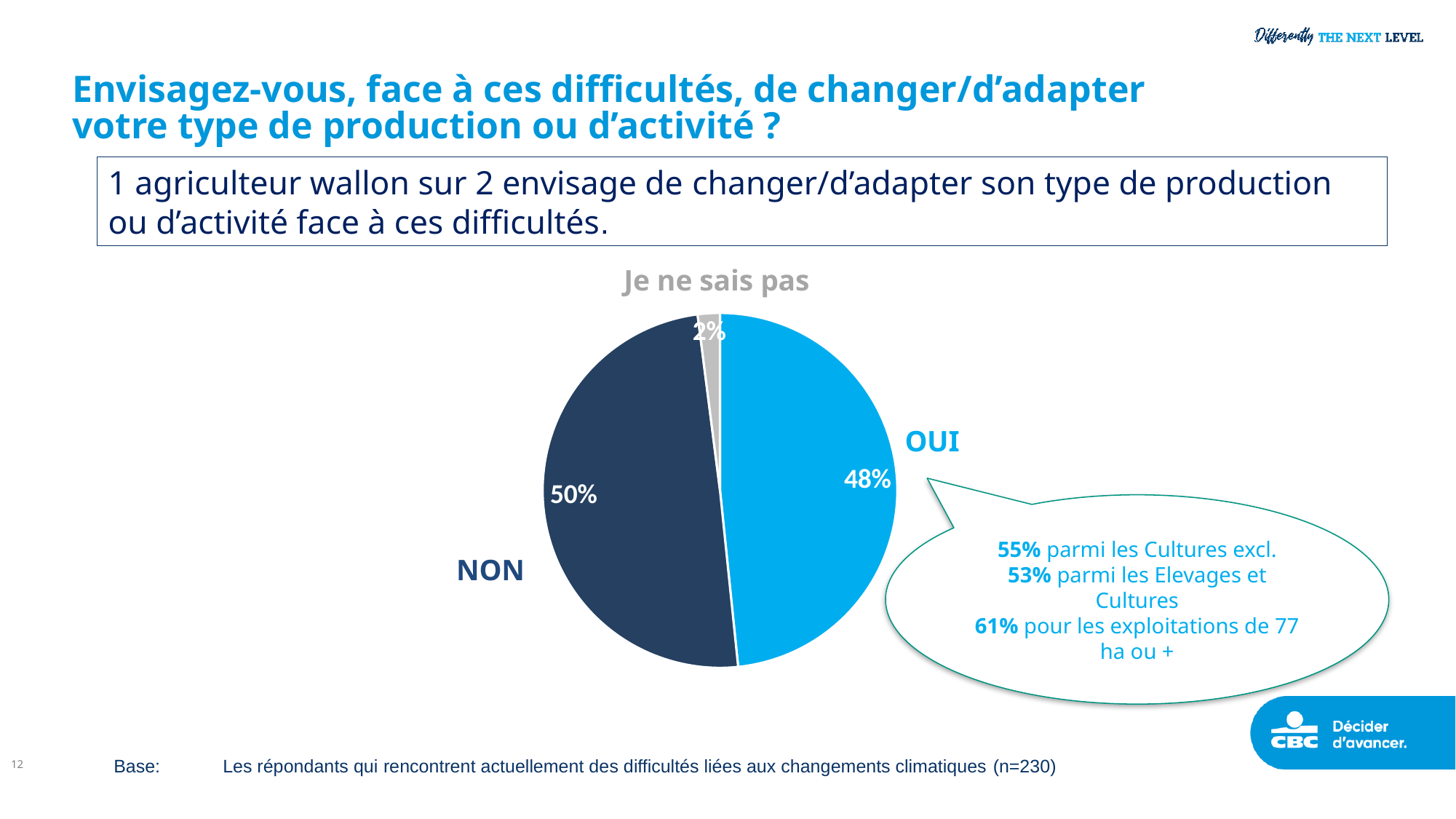
What kind of chart is shown on the slide? pie chart Which colour is used for the OUI slice? light blue What is the sample size (n) stated in the base note below the chart? n=230 What is the difference in percentage points between NON and OUI? 2 Which colour is used for the 'Je ne sais pas' slice? grey What is the difference in percentage points between OUI and 'Je ne sais pas'? 46 What percentage of respondents answered NON? 50% Which category has the smallest slice of the pie? Je ne sais pas How many categories are shown in the pie chart? 3 Which category has the largest slice of the pie? NON What percentage of respondents answered OUI? 48% What percentage of respondents answered 'Je ne sais pas'? 2%